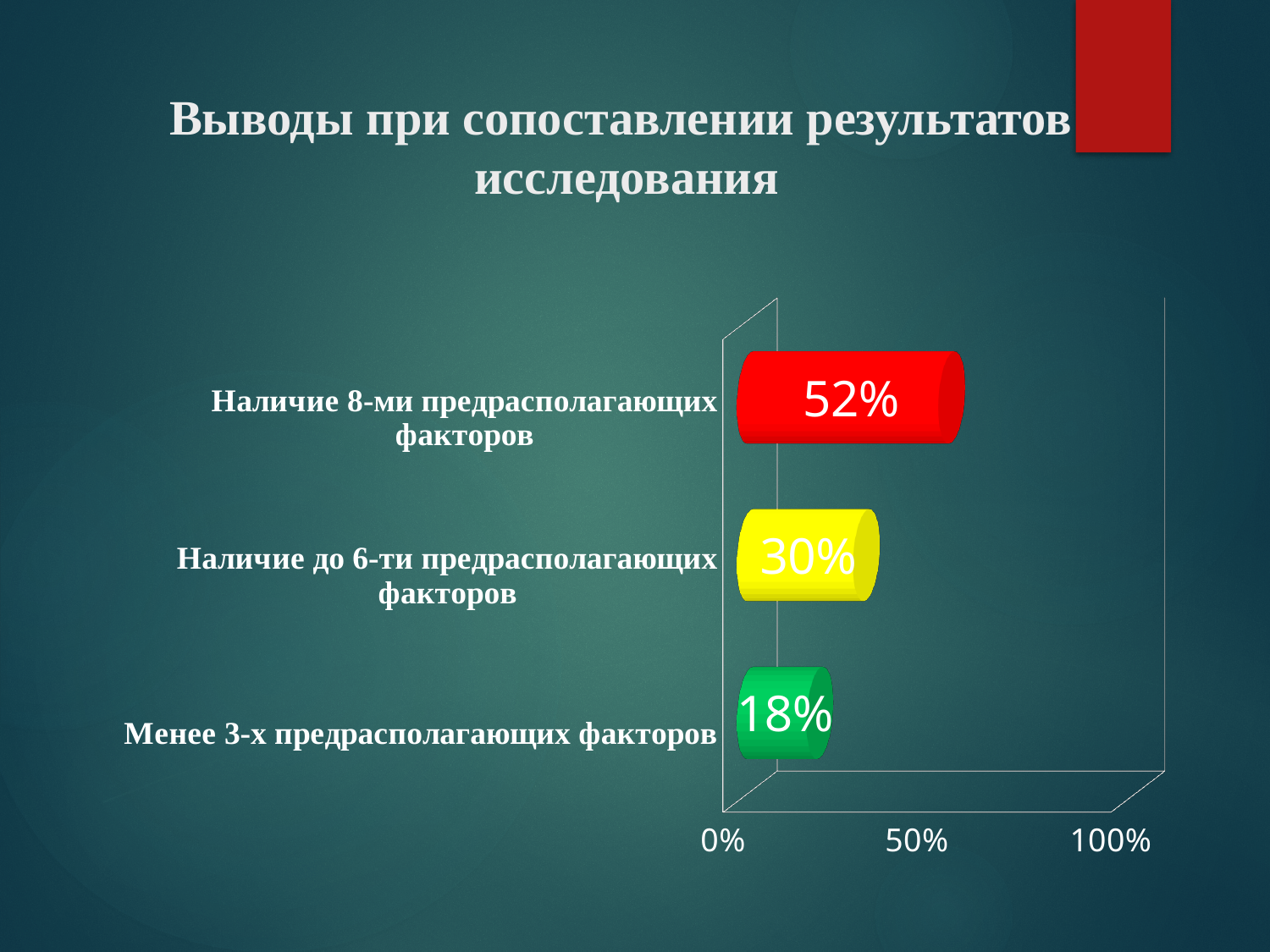
What is the value for "Менее 3-х предрасполагающих факторов"? 18% Is the value for "Наличие 8-ми предрасполагающих факторов" greater or less than 50%? greater What colour is the bar for "Наличие до 6-ти предрасполагающих факторов"? yellow Which category has the lowest value? Менее 3-х предрасполагающих факторов What is the value for "Наличие 8-ми предрасполагающих факторов"? 52% Which is larger: the value for "Наличие до 6-ти предрасполагающих факторов" or for "Менее 3-х предрасполагающих факторов"? Наличие до 6-ти предрасполагающих факторов What kind of chart is shown on the slide? bar chart What is the difference between the values for "Наличие 8-ми предрасполагающих факторов" and "Наличие до 6-ти предрасполагающих факторов"? 22% How many categories are shown in the chart? 3 Which category has the highest value? Наличие 8-ми предрасполагающих факторов What is the difference between the values for "Наличие до 6-ти предрасполагающих факторов" and "Менее 3-х предрасполагающих факторов"? 12% What is the value for "Наличие до 6-ти предрасполагающих факторов"? 30%